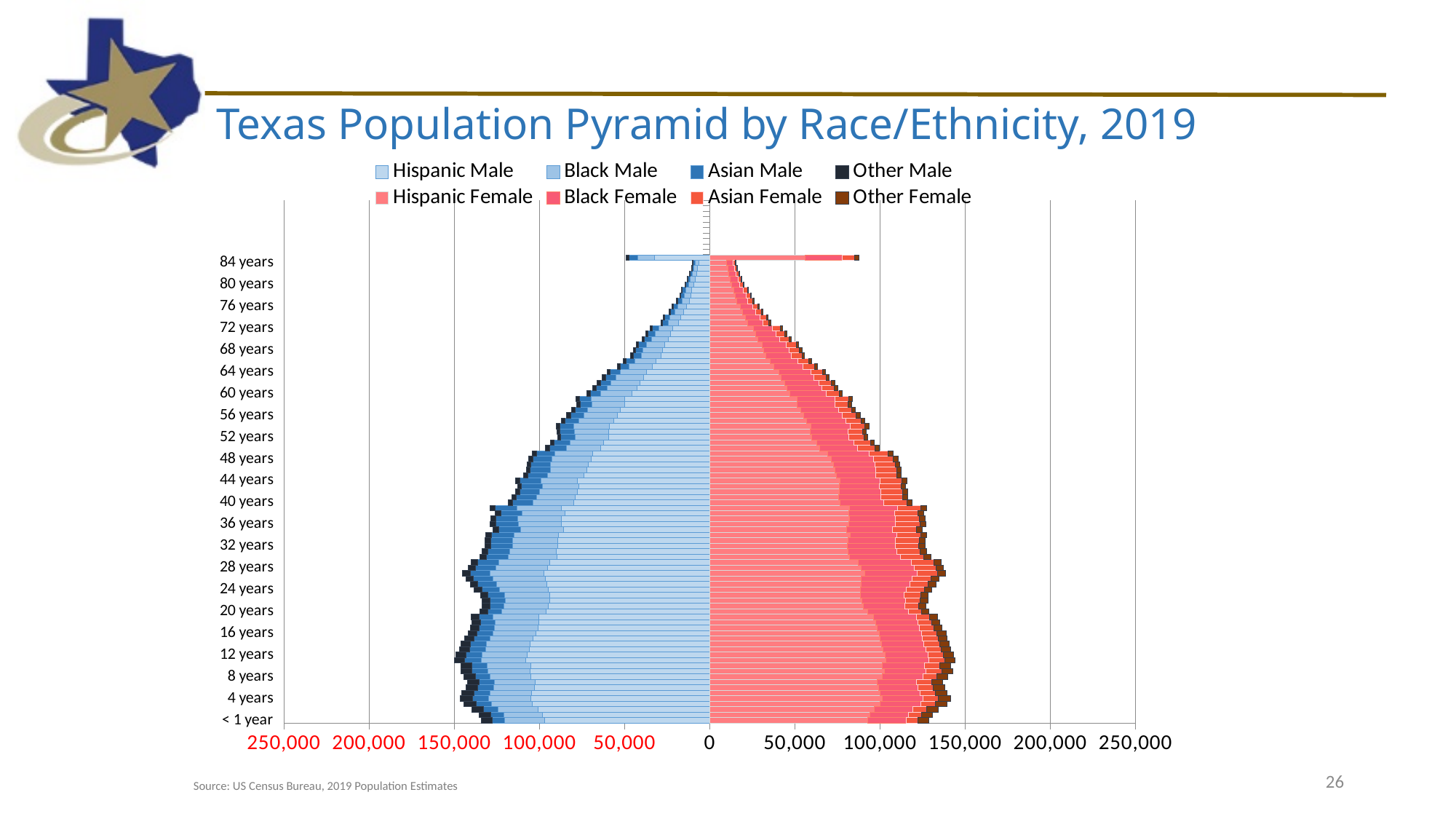
What kind of chart is shown on the slide? Bar chart Do the bar lengths rise or fall as age increases from 40 years to 80 years? Fall Is the total female value for the 84 years age group greater or less than 100,000? less Which series makes up the largest part of the male bars? Hispanic Male Is the total female value for the < 1 year age group greater or less than 100,000? greater Which series are shown in shades of blue, male or female? Male Is the total female value for the 84 years age group greater or less than 50,000? less How many series does the legend list? 8 What is the title of the chart? Texas Population Pyramid by Race/Ethnicity, 2019 For the 84 years age group, which side has the longer bar, male or female? Female